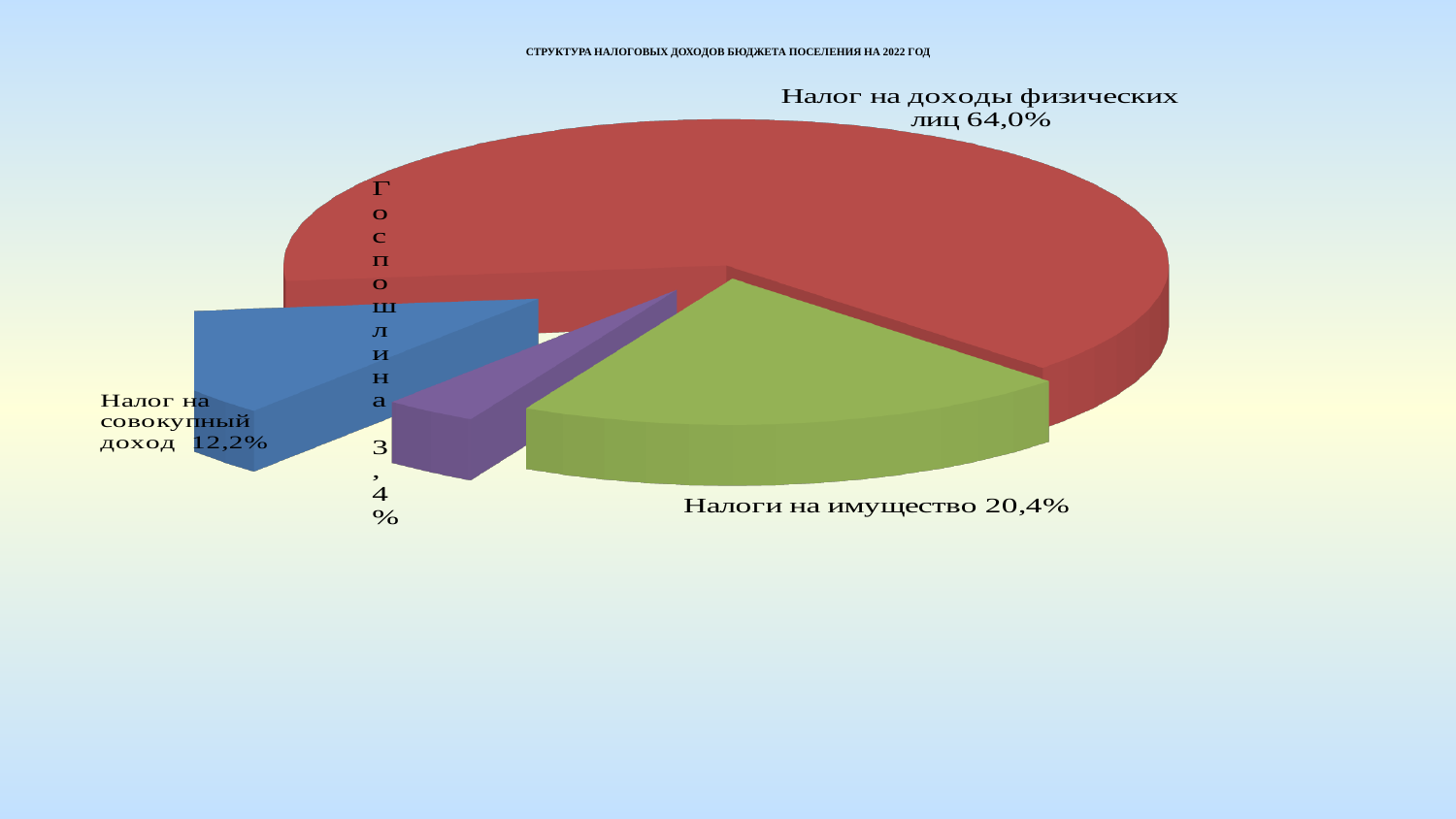
What kind of chart is shown on the slide? Pie chart Which category has the largest share of the pie? Налог на доходы физических лиц Which is larger: the share for "Налоги на имущество" or for "Налог на совокупный доход"? Налоги на имущество How many slices does the pie chart have? 4 What share is shown for "Налоги на имущество"? 20,4% What share is shown for "Налог на совокупный доход"? 12,2% What is the difference in percentage points between "Налог на совокупный доход" and "Госпошлина"? 8,8 Which category has the smallest share of the pie? Госпошлина What share of tax revenues does "Налог на доходы физических лиц" account for? 64,0% What is the title of the chart? СТРУКТУРА НАЛОГОВЫХ ДОХОДОВ БЮДЖЕТА ПОСЕЛЕНИЯ НА 2022 ГОД What is the difference in percentage points between "Налог на доходы физических лиц" and "Налоги на имущество"? 43,6 What share is shown for "Госпошлина"? 3,4%